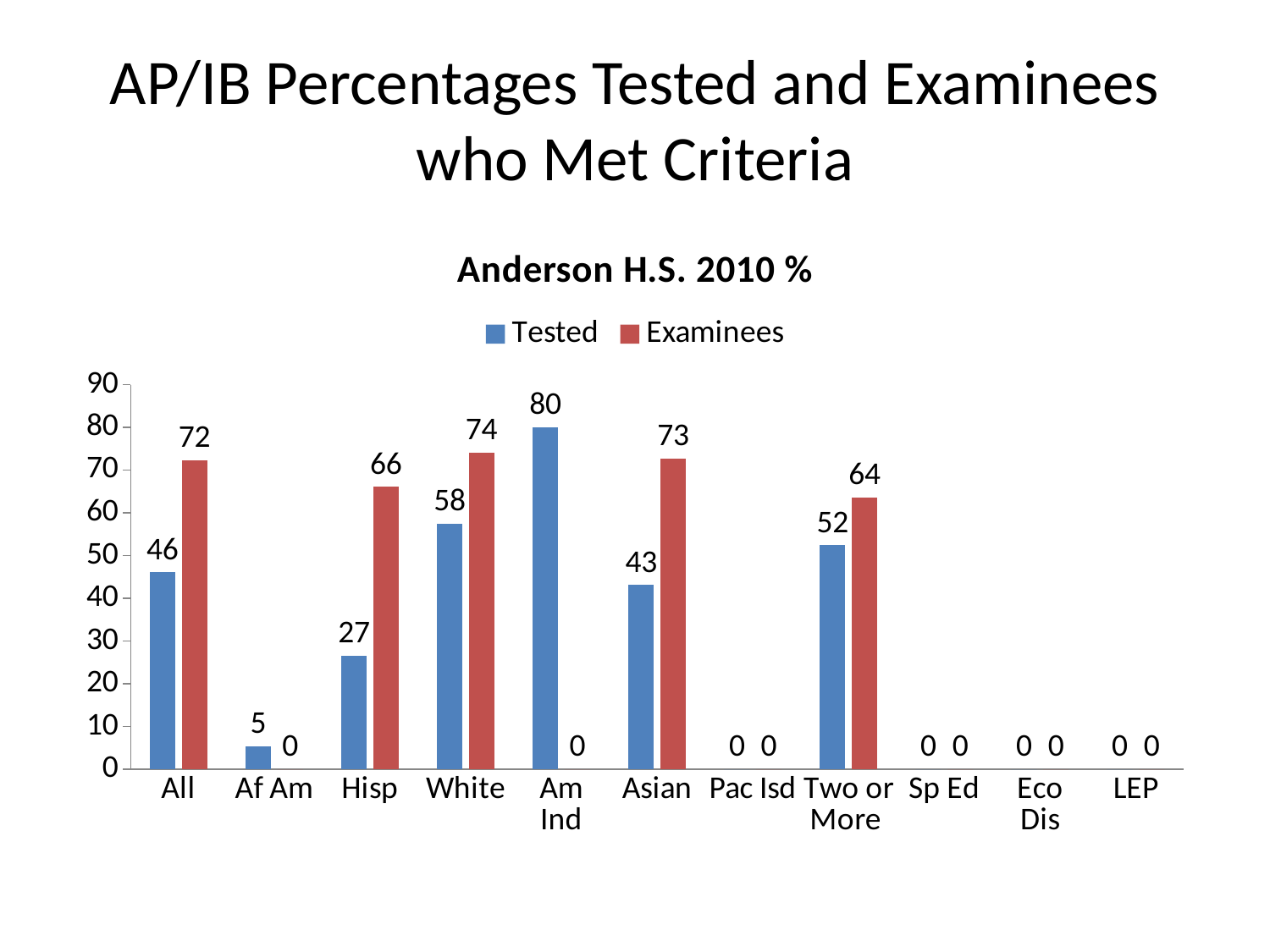
What kind of chart is shown? bar chart What is the Tested value for Am Ind? 80 What is the Examinees value for Two or More? 64 What is the difference between the Examinees and Tested values for All? 26 What is the title of the chart? Anderson H.S. 2010 % What is the Examinees value for Hisp? 66 How many categories are shown on the x axis? 11 Which is larger for Asian, the Tested value or the Examinees value? Examinees What is the Tested value for All? 46 Which category has the highest Tested value? Am Ind How many series does the legend list? 2 Which category has the highest Examinees value? White